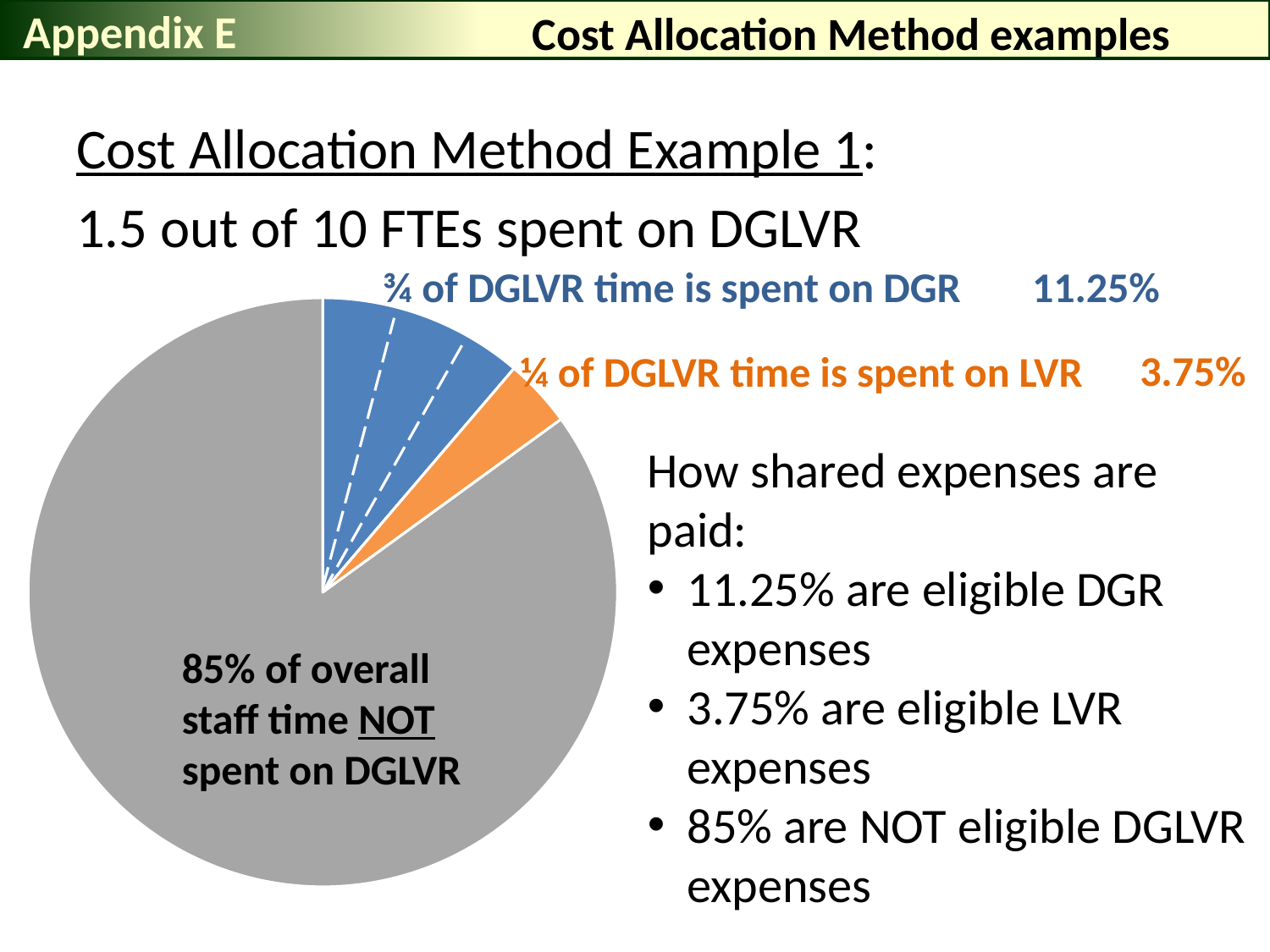
What percentage of time is spent on DGR according to the pie chart labels? 11.25% What percentage of time is spent on LVR according to the pie chart labels? 3.75% What kind of chart is shown on the slide? pie chart Which is larger in the pie chart, the DGR share or the LVR share? DGR What colour is the slice representing time spent on DGR? blue Which slice of the pie chart is the largest? 85% of overall staff time NOT spent on DGLVR What is the difference between the DGR share and the LVR share in the pie chart? 7.5% How many slices does the pie chart have? 3 Which slice of the pie chart is the smallest? LVR (3.75%) What is the combined share of the DGR and LVR slices in the pie chart? 15% What colour is the slice representing time spent on LVR? orange What share of overall staff time is NOT spent on DGLVR according to the pie chart? 85%